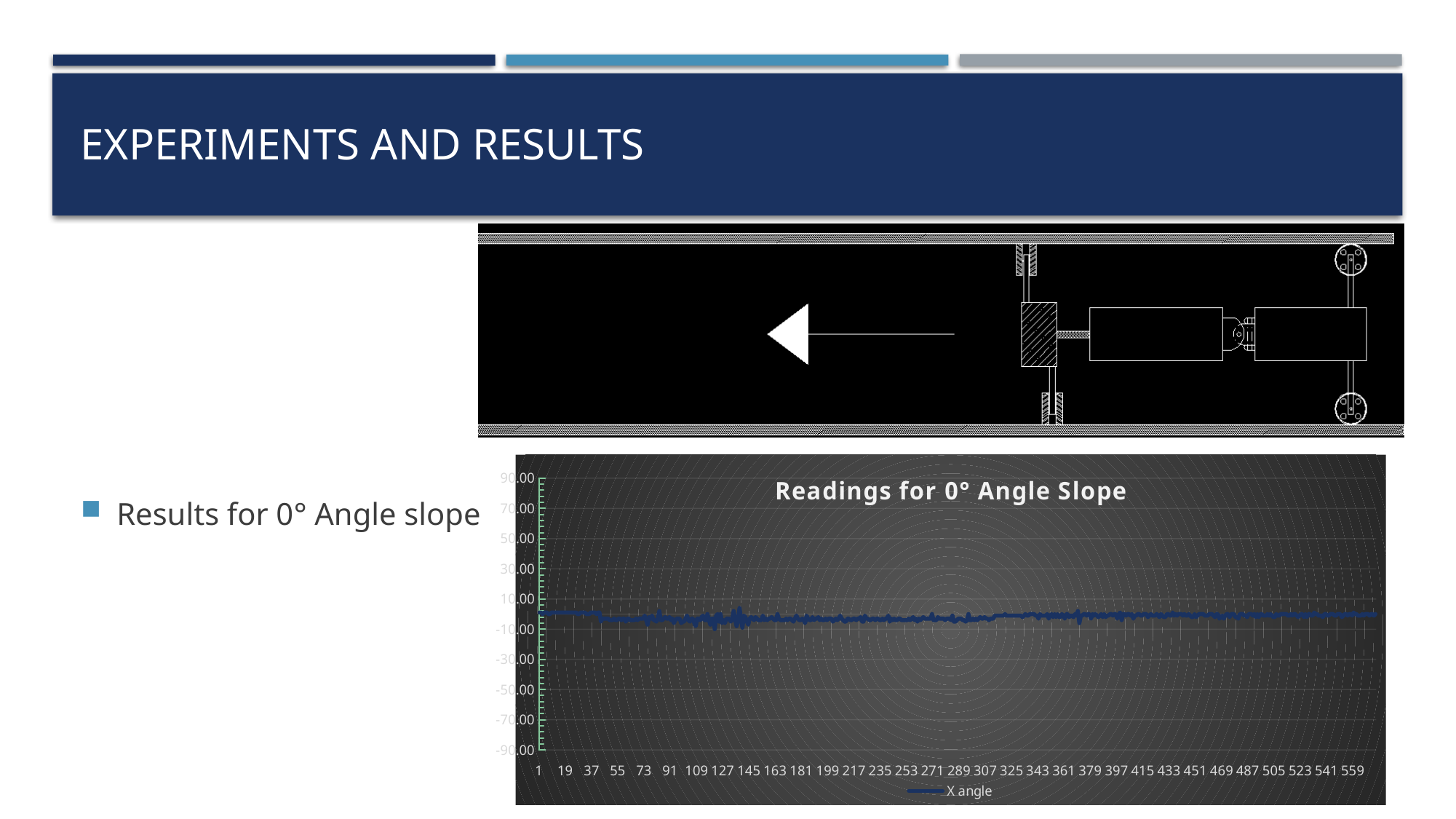
What series name is shown in the chart's legend? X angle What is the title of the chart on the slide? Readings for 0° Angle Slope Is the X angle value at reading 289 greater or less than 30.00? less What kind of chart is shown on the slide? line chart Is the X angle value at reading 145 greater or less than 50.00? less Is the X angle value at reading 1 greater or less than 10.00? less How many series does the chart's legend list? 1 Does the X angle line rise sharply, fall sharply, or stay roughly flat across the readings? stays roughly flat